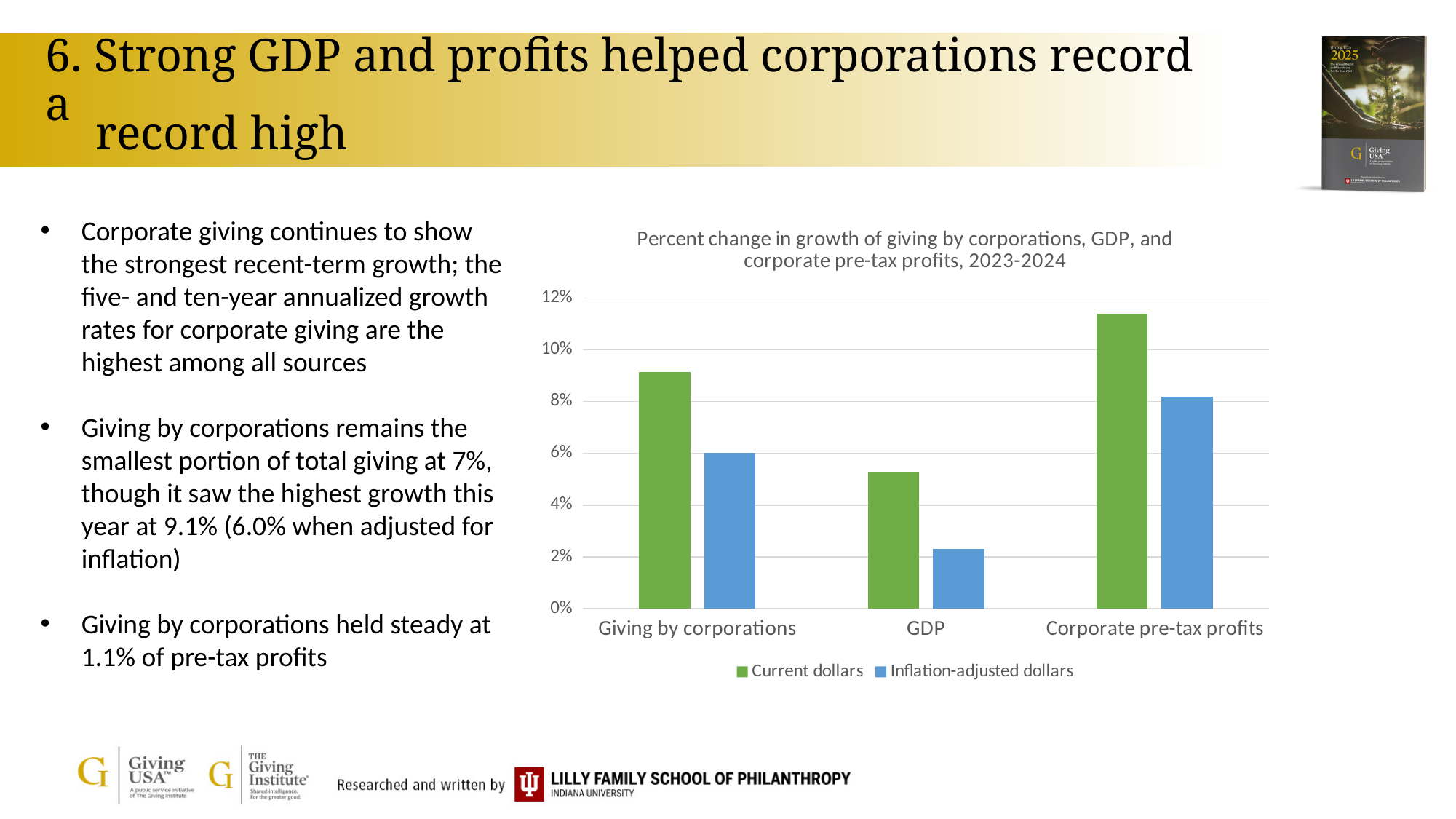
Is the Current dollars value for Corporate pre-tax profits greater or less than 10%? greater Is the Current dollars value for Giving by corporations greater or less than 8%? greater How many categories are shown on the x axis of the chart? 3 What kind of chart is shown on the slide? Bar chart Is the Inflation-adjusted dollars value for GDP greater or less than 4%? less Which category has the lowest Inflation-adjusted dollars value? GDP How many series does the chart's legend list? 2 What is the Inflation-adjusted dollars value for Giving by corporations? 6% Which category has the highest Current dollars value? Corporate pre-tax profits What colour represents the Inflation-adjusted dollars series in the chart? Blue For GDP, which series has the larger value: Current dollars or Inflation-adjusted dollars? Current dollars Which is larger: the Current dollars value for GDP or the Current dollars value for Giving by corporations? Giving by corporations